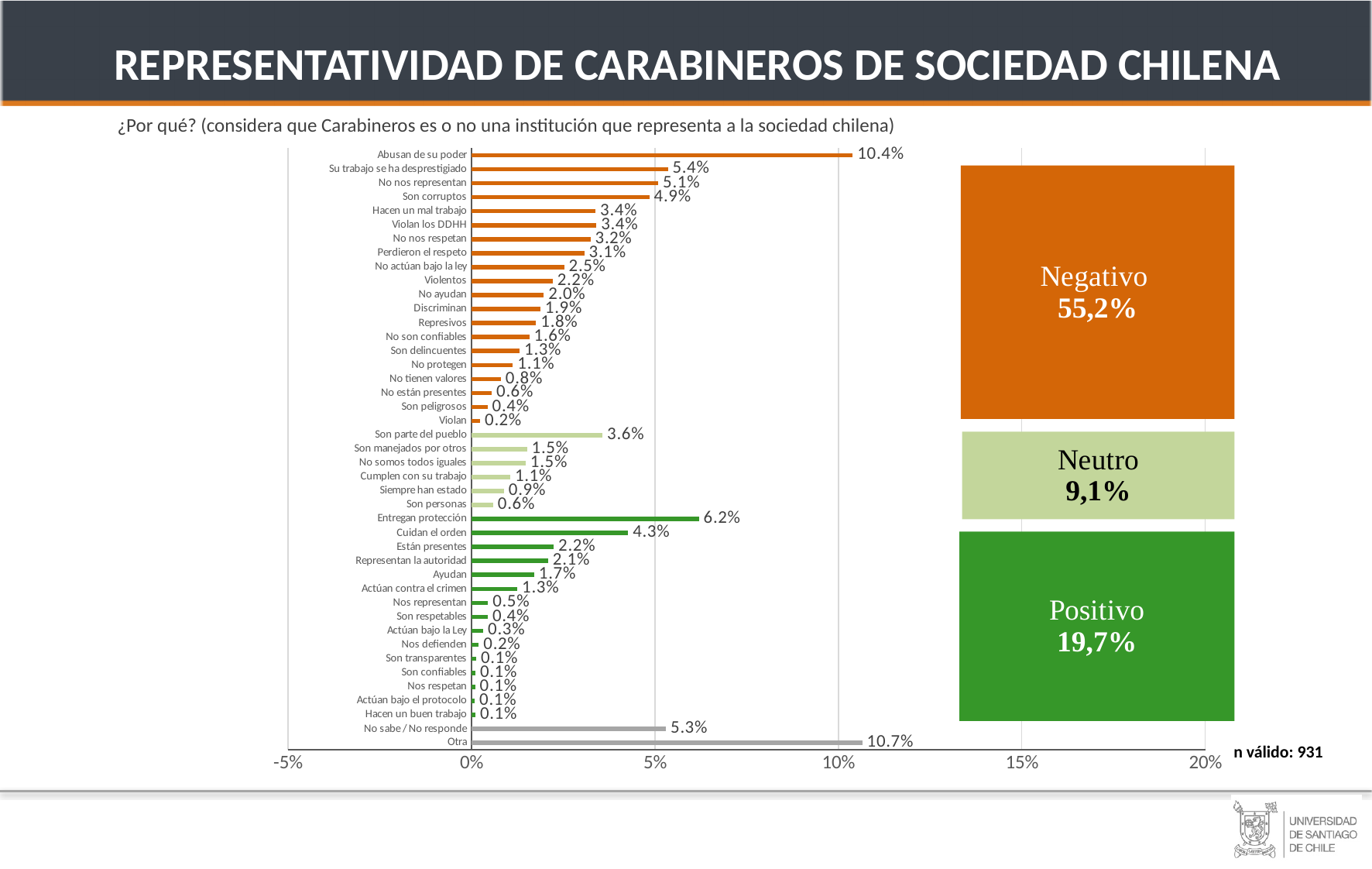
What is the valid n ("n válido") shown on the slide? 931 What percentage is shown in the "Negativo" box on the right of the slide? 55,2% Which category has the highest value in the chart? Otra Is the value for "Abusan de su poder" greater or less than 10%? greater What is the difference between the values for "Otra" and "Abusan de su poder"? 0.3% What is the value for "Son parte del pueblo"? 3.6% What is the value for "No sabe / No responde"? 5.3% Which is larger, the value for "Cuidan el orden" or the value for "Son corruptos"? Son corruptos What is the value for "Abusan de su poder"? 10.4% What is the difference between the values for "Su trabajo se ha desprestigiado" and "No nos representan"? 0.3% What is the value for "Entregan protección"? 6.2% What kind of chart is shown on the slide? Bar chart